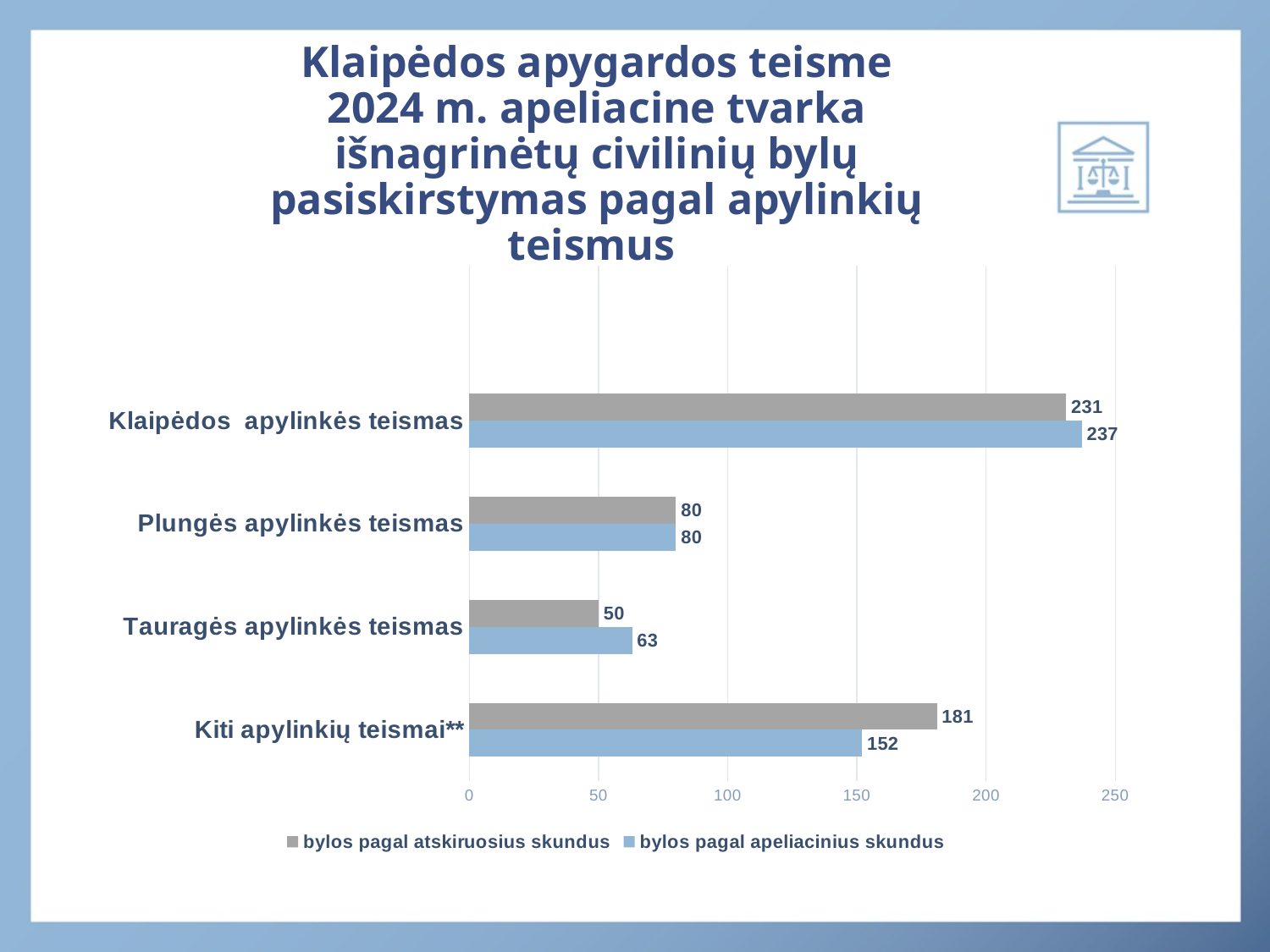
How many series does the legend list? 2 What is the value for Kiti apylinkių teismai** in the 'bylos pagal atskiruosius skundus' series? 181 How many courts (categories) are shown on the chart? 4 What is the value for Klaipėdos apylinkės teismas in the 'bylos pagal apeliacinius skundus' series? 237 What is the total of the two series values for Plungės apylinkės teismas? 160 What is the difference between the 'bylos pagal apeliacinius skundus' values for Klaipėdos apylinkės teismas and Plungės apylinkės teismas? 157 For Tauragės apylinkės teismas, which series has the larger value: 'bylos pagal atskiruosius skundus' or 'bylos pagal apeliacinius skundus'? bylos pagal apeliacinius skundus What is the value for Tauragės apylinkės teismas in the 'bylos pagal apeliacinius skundus' series? 63 What is the difference between the 'bylos pagal atskiruosius skundus' and 'bylos pagal apeliacinius skundus' values for Kiti apylinkių teismai**? 29 Which court has the lowest value in the 'bylos pagal apeliacinius skundus' series? Tauragės apylinkės teismas Which court has the highest value in the 'bylos pagal atskiruosius skundus' series? Klaipėdos apylinkės teismas What kind of chart is shown on the slide? Bar chart